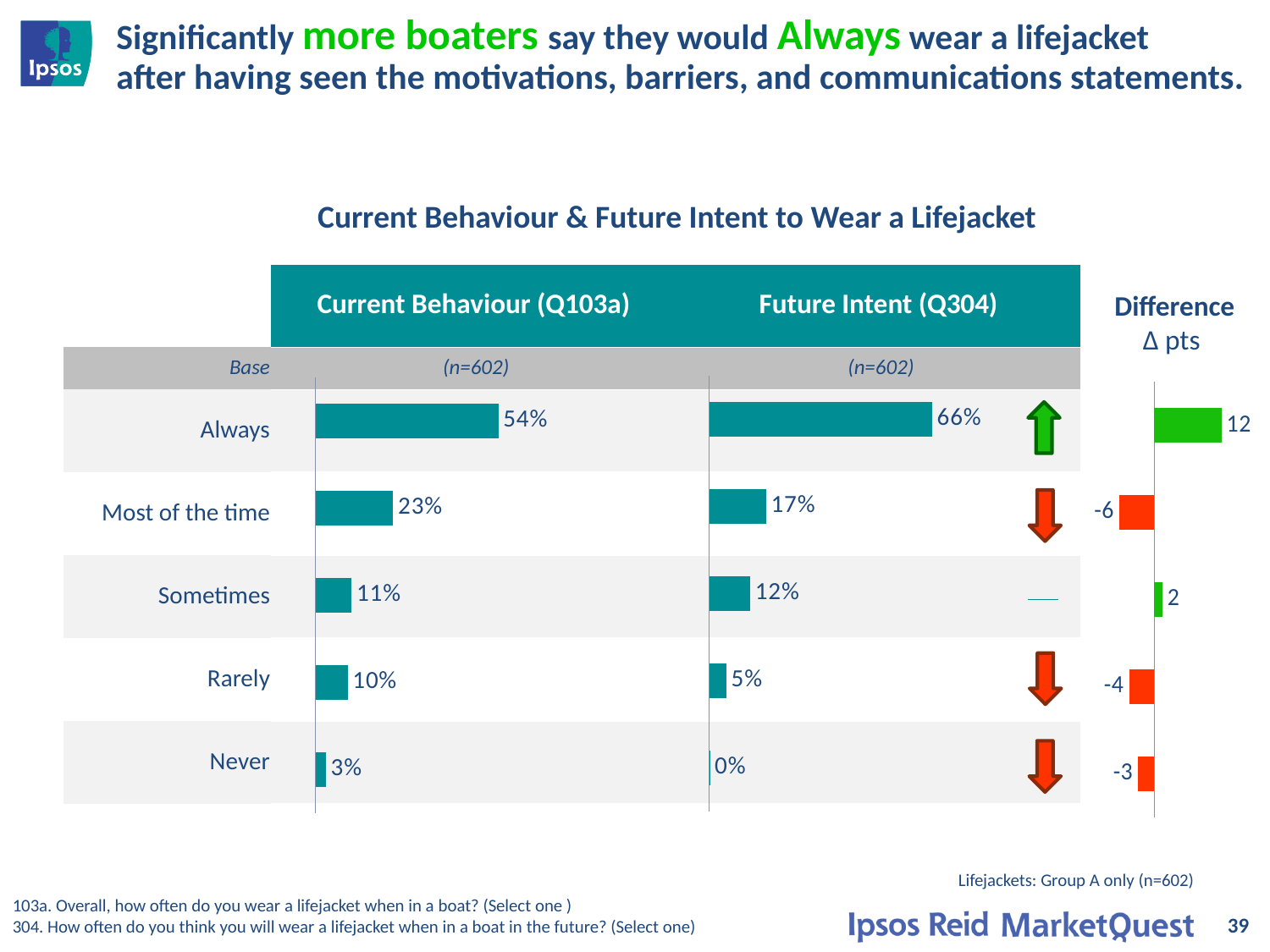
Which is larger: the Current Behaviour (Q103a) value for Most of the time or the Future Intent (Q304) value for Most of the time? Current Behaviour (Q103a) How many categories are shown in the Current Behaviour (Q103a) chart? 5 What is the difference between the Future Intent (Q304) and Current Behaviour (Q103a) values for Always? 12 What kind of chart is the Current Behaviour (Q103a) chart? Bar chart In the Current Behaviour (Q103a) chart, what percentage of boaters say they Always wear a lifejacket? 54% In the Future Intent (Q304) chart, what is the value for Rarely? 5% What is the title of the chart on the slide? Current Behaviour & Future Intent to Wear a Lifejacket In the Current Behaviour (Q103a) chart, which category has the lowest value? Never In the Future Intent (Q304) chart, what percentage of boaters say they will Always wear a lifejacket? 66% In the Difference chart, what is the value for Never? -3 In the Difference chart, what is the value for Most of the time? -6 In the Future Intent (Q304) chart, which category has the highest value? Always